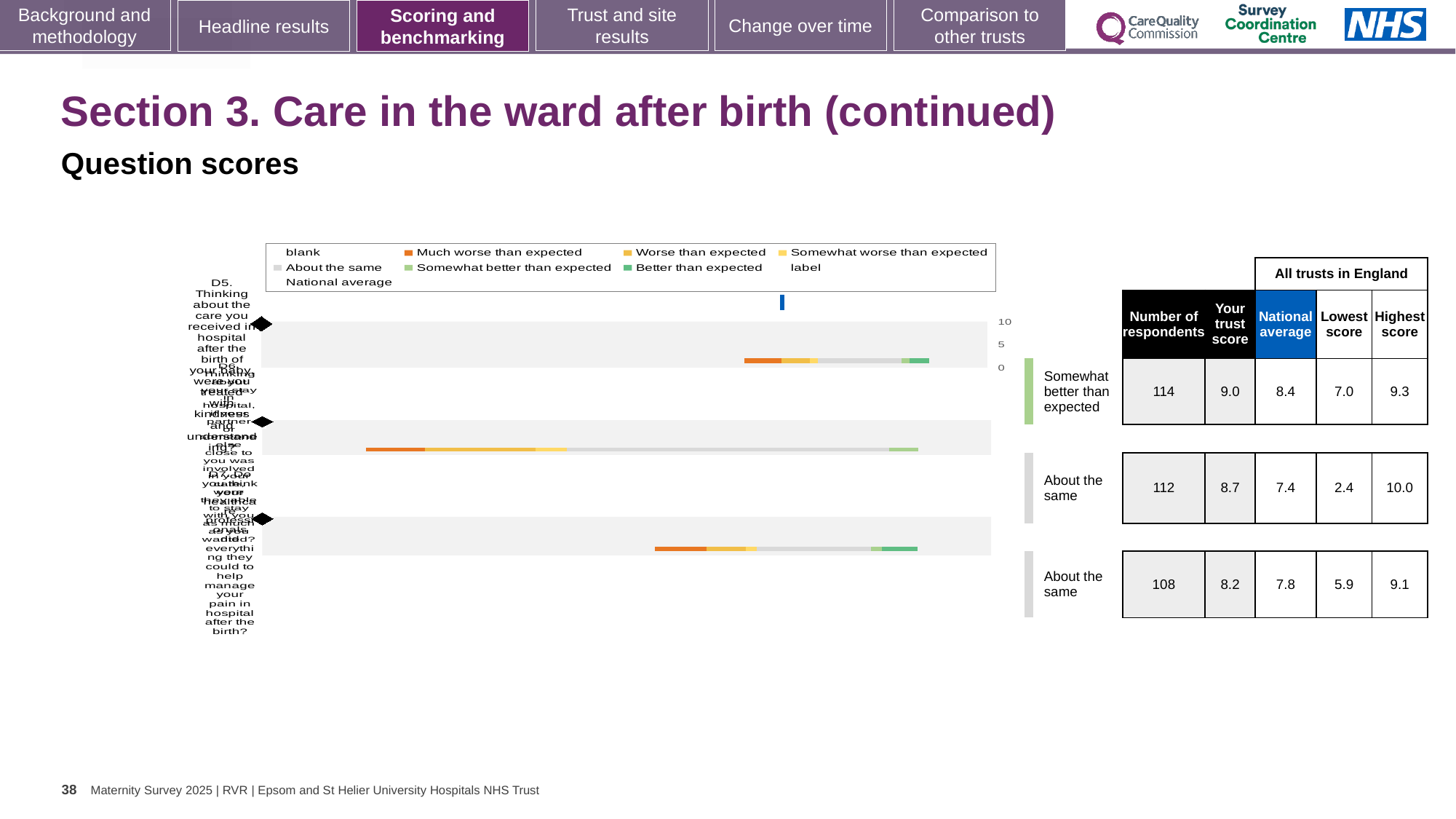
How many question rows are plotted in the chart? 3 What is the lowest score among all trusts in England for the second (middle) question row? 2.4 Which question row has the lowest number of respondents? the third (bottom) row What is the number of respondents for the first (top) question row? 114 What kind of chart is shown on the slide? bar chart What is the 'Your trust score' for the first (top) question row? 9.0 What is the national average for the second (middle) question row? 7.4 What benchmark label is shown next to the first (top) question row? Somewhat better than expected What is the difference between the trust score and the national average for the first (top) question row? 0.6 What is the highest score among all trusts in England for the third (bottom) question row? 9.1 Which question row has the highest 'Your trust score'? the first (top) row For the second (middle) question row, which is larger: the trust score or the national average? the trust score